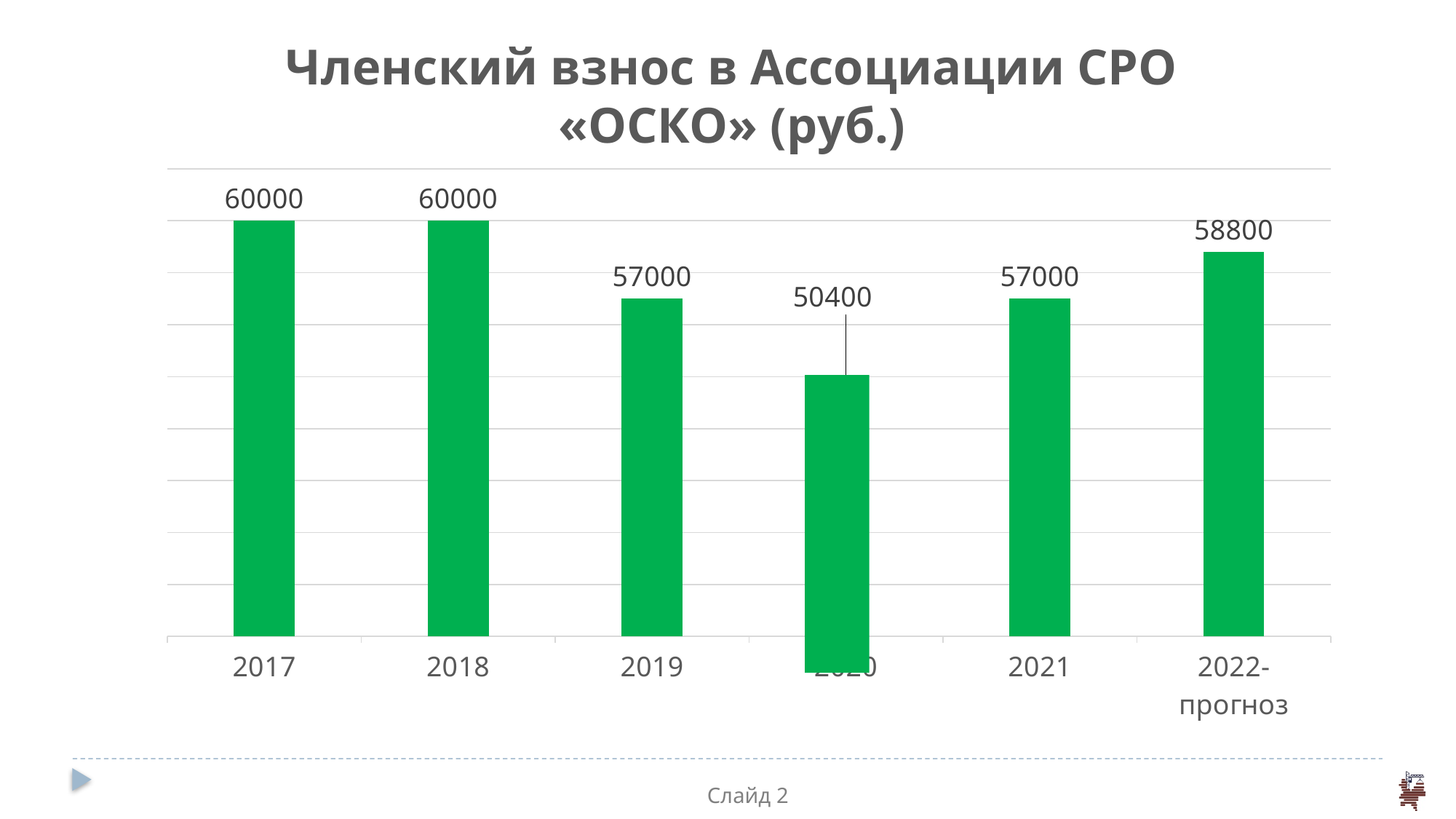
How many years (categories) are shown on the x axis? 6 Which year has the lowest membership fee? 2020 What is the difference between the values for 2018 and 2019? 3000 Which is larger, the value for 2021 or the value for 2022-прогноз? 2022-прогноз What is the highest value shown on the chart? 60000 What is the value shown for 2022-прогноз? 58800 What value is labelled on the bar for 2020? 50400 What is the title of the chart? Членский взнос в Ассоциации СРО «ОСКО» (руб.) By how much does the value for 2021 exceed the value for 2020? 6600 What is the membership fee value shown for 2019? 57000 What type of chart is shown on the slide? Bar chart What is the value shown for 2017? 60000